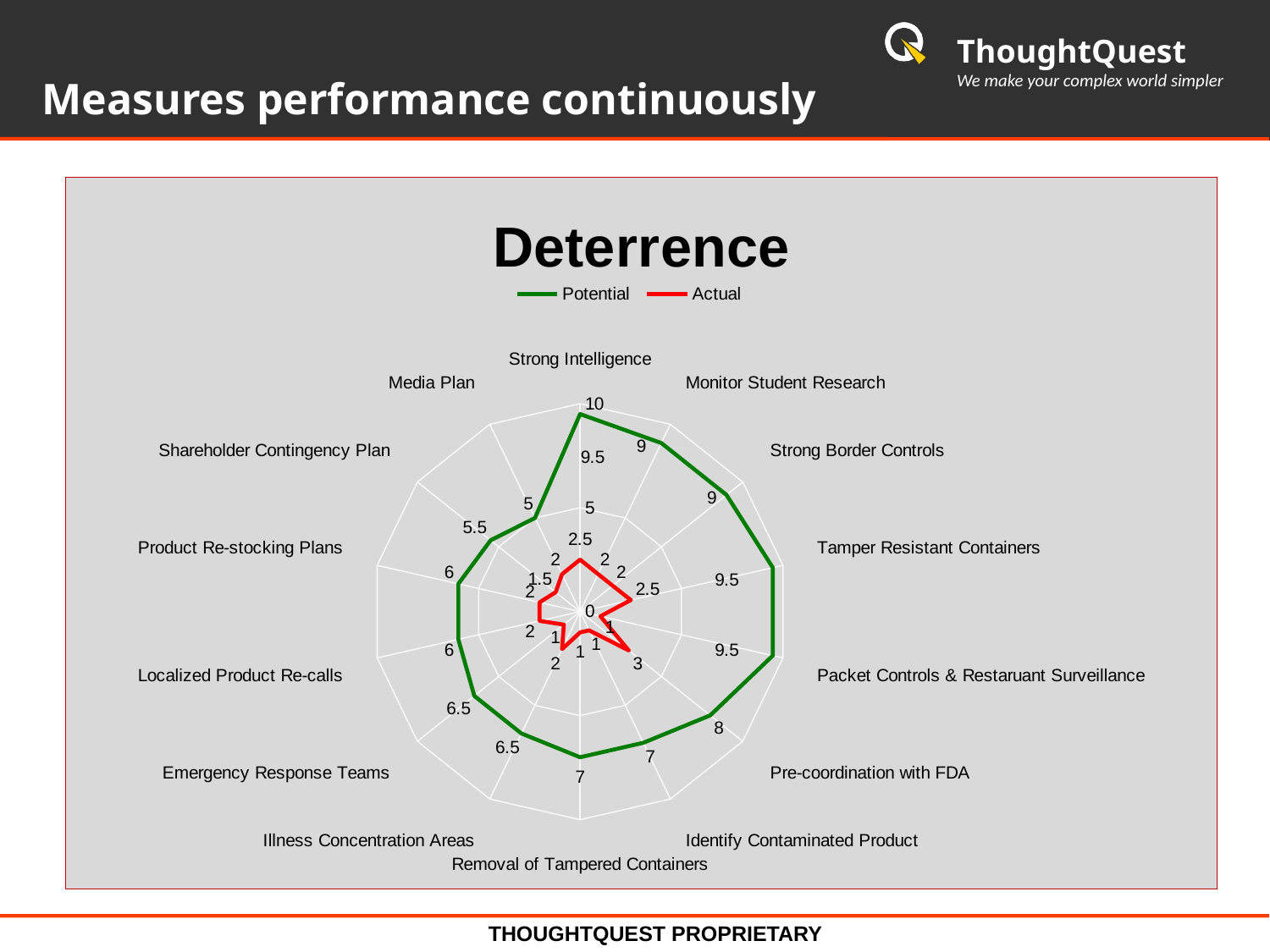
Which colour represents the Actual series in the Deterrence chart? Red Which category has the lowest Potential value? Media Plan What is the Potential value for Pre-coordination with FDA? 8 What is the difference between the Potential and Actual values for Strong Intelligence? 7 How many series does the legend of the Deterrence chart list? 2 What kind of chart is shown on the slide? Radar chart What is the Potential value for Strong Intelligence? 9.5 How many categories are plotted on the Deterrence radar chart? 14 Which is larger, the Potential value for Tamper Resistant Containers or the Potential value for Illness Concentration Areas? Tamper Resistant Containers What is the Actual value for Pre-coordination with FDA? 3 What is the Potential value for Media Plan? 5